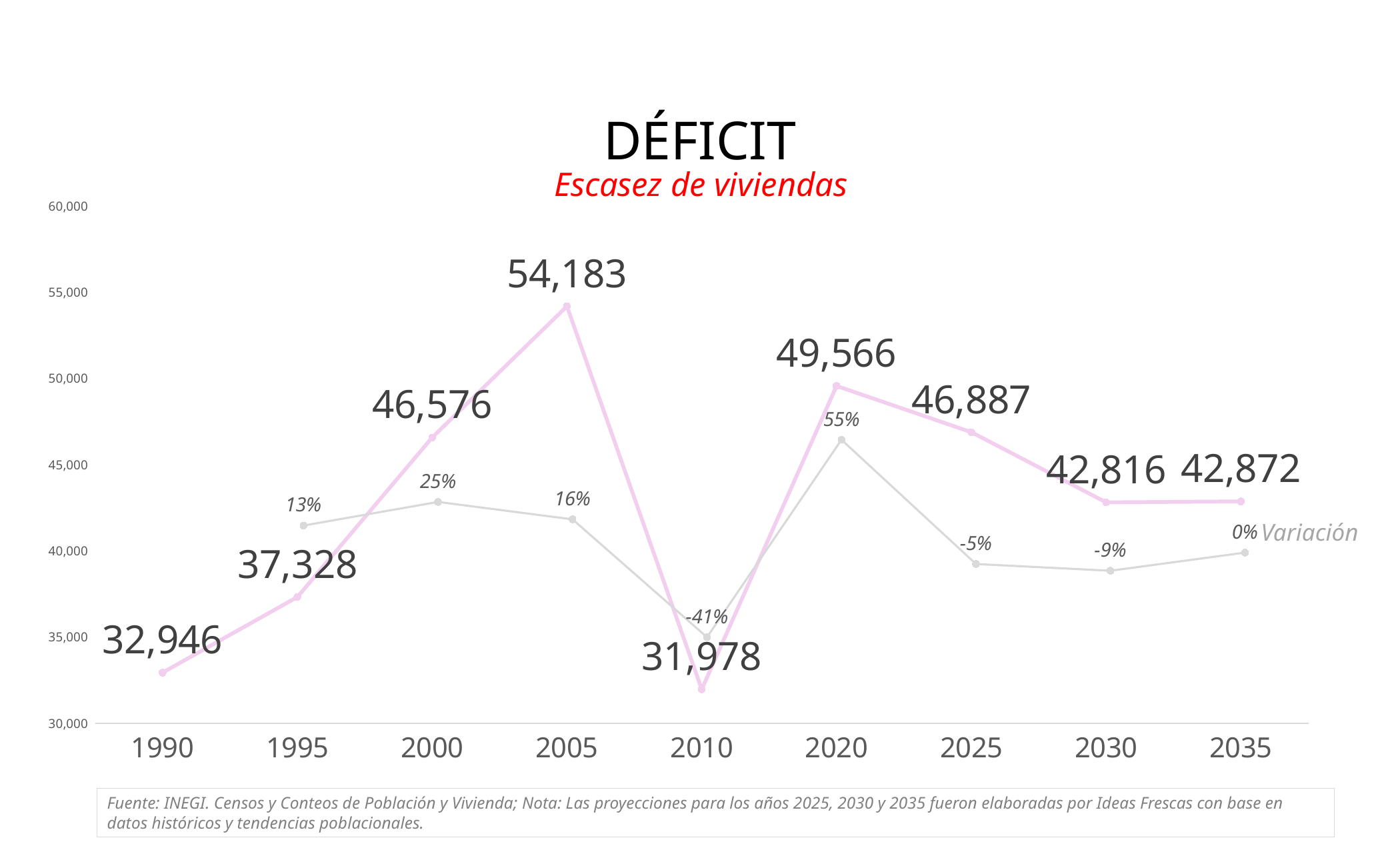
How many years are shown on the x axis? 9 What is the difference between the deficit values for 2005 and 2010? 22,205 Which year has a larger deficit value, 2000 or 2025? 2025 What is the subtitle shown in red below the chart title? Escasez de viviendas What is the Variación percentage shown for 2010? -41% What kind of chart is shown on the slide? Line chart What is the housing deficit value shown for 2005? 54,183 What is the housing deficit value shown for 1990? 32,946 In which year is the housing deficit lowest? 2010 In which year is the housing deficit highest? 2005 What is the housing deficit value shown for 2035? 42,872 What is the Variación percentage shown for 2020? 55%